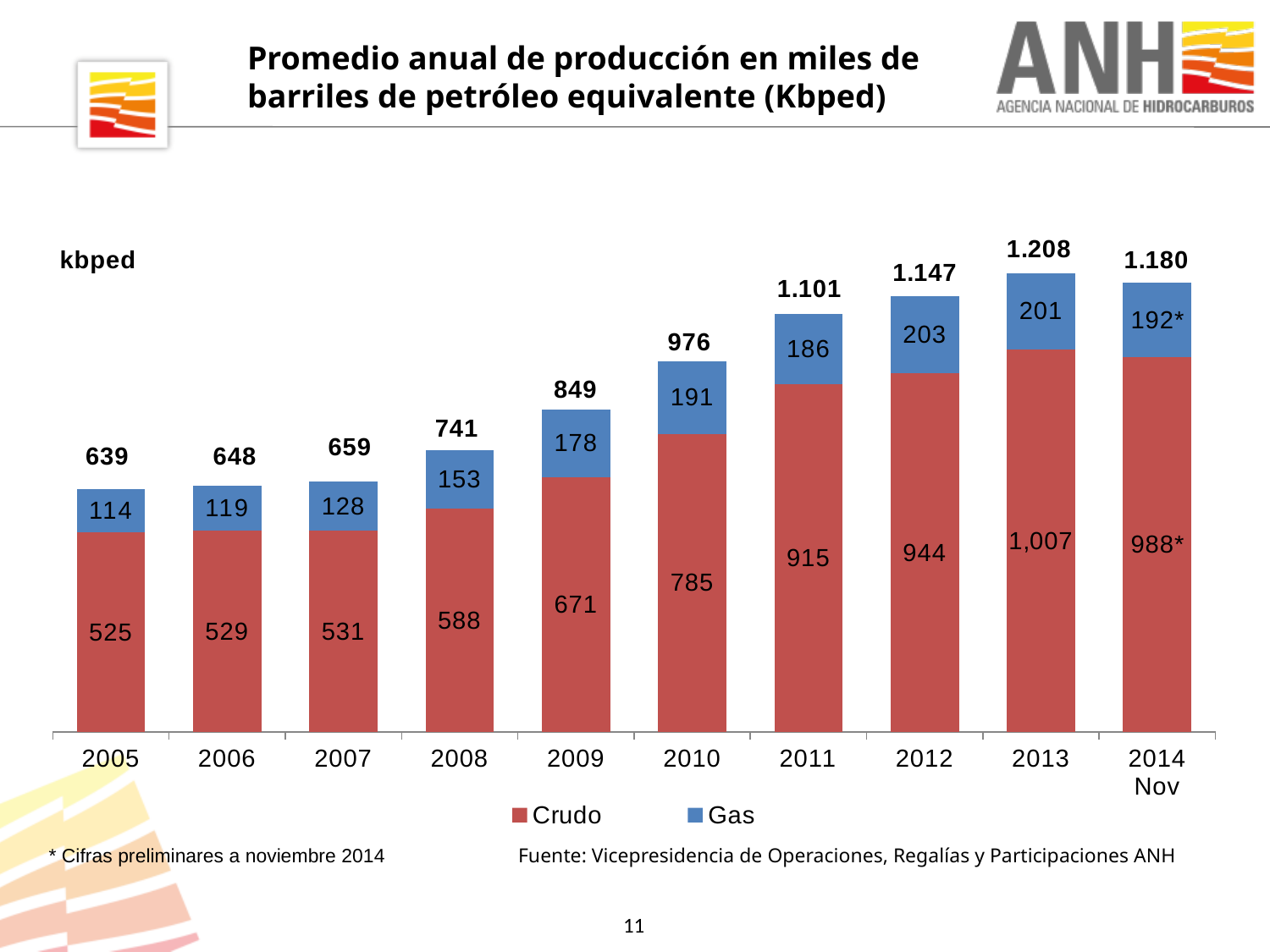
Which year has the highest total production? 2013 Do the Crudo values rise or fall from 2005 to 2013? Rise Which series is shown in blue in the legend? Gas What kind of chart is shown on the slide? Stacked bar chart What is the Crudo value for 2009? 671 Which year has the lowest Crudo value? 2005 What is the difference between the Crudo values for 2010 and 2009? 114 Which is larger, the Gas value for 2010 or the Gas value for 2011? 2010 What is the total labelled above the stacked bar for 2011? 1.101 How many series does the legend list? 2 What is the Gas value for 2012? 203 How many years are shown on the x axis? 10